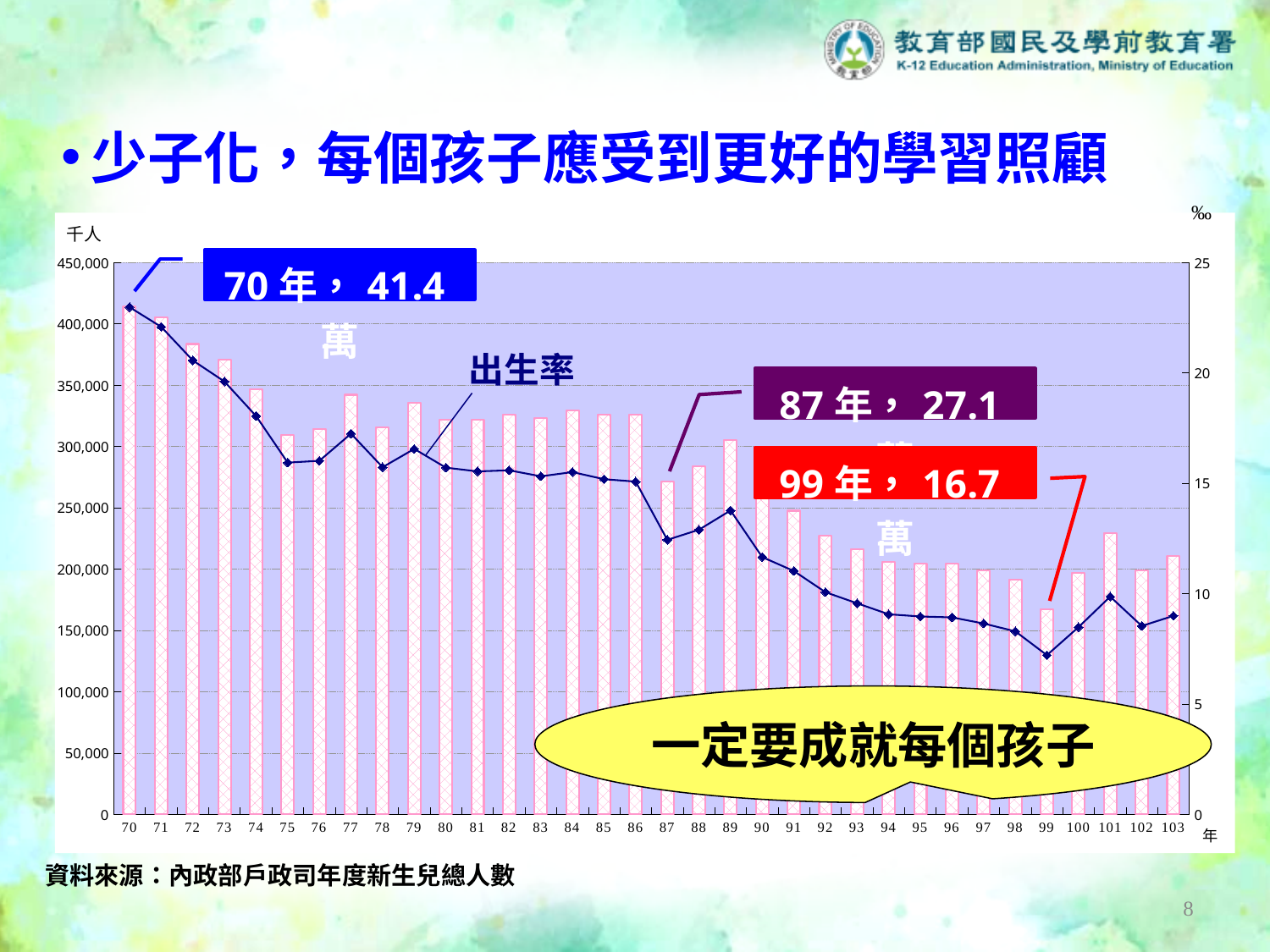
What kind of chart is shown on the slide? A combined bar and line chart What is the overall trend of the birth rate line from year 70 to year 103? Falling According to the callout, what was the number of newborns in year 99? 16.7萬 Which year has the lowest bar in the chart? 99 How many years are shown along the x axis of the chart? 34 According to the callout, what was the number of newborns in year 87? 27.1萬 What is the difference between the newborn counts shown in the callouts for year 70 and year 99? 24.7萬 Which is larger, the bar for year 70 or the bar for year 103? Year 70 Is the birth rate (出生率) line value for year 70 greater or less than 20‰? greater Is the bar for year 99 greater or less than 200,000? less What unit is shown on the left vertical axis of the chart? 千人 According to the callout, what was the number of newborns in year 70? 41.4萬